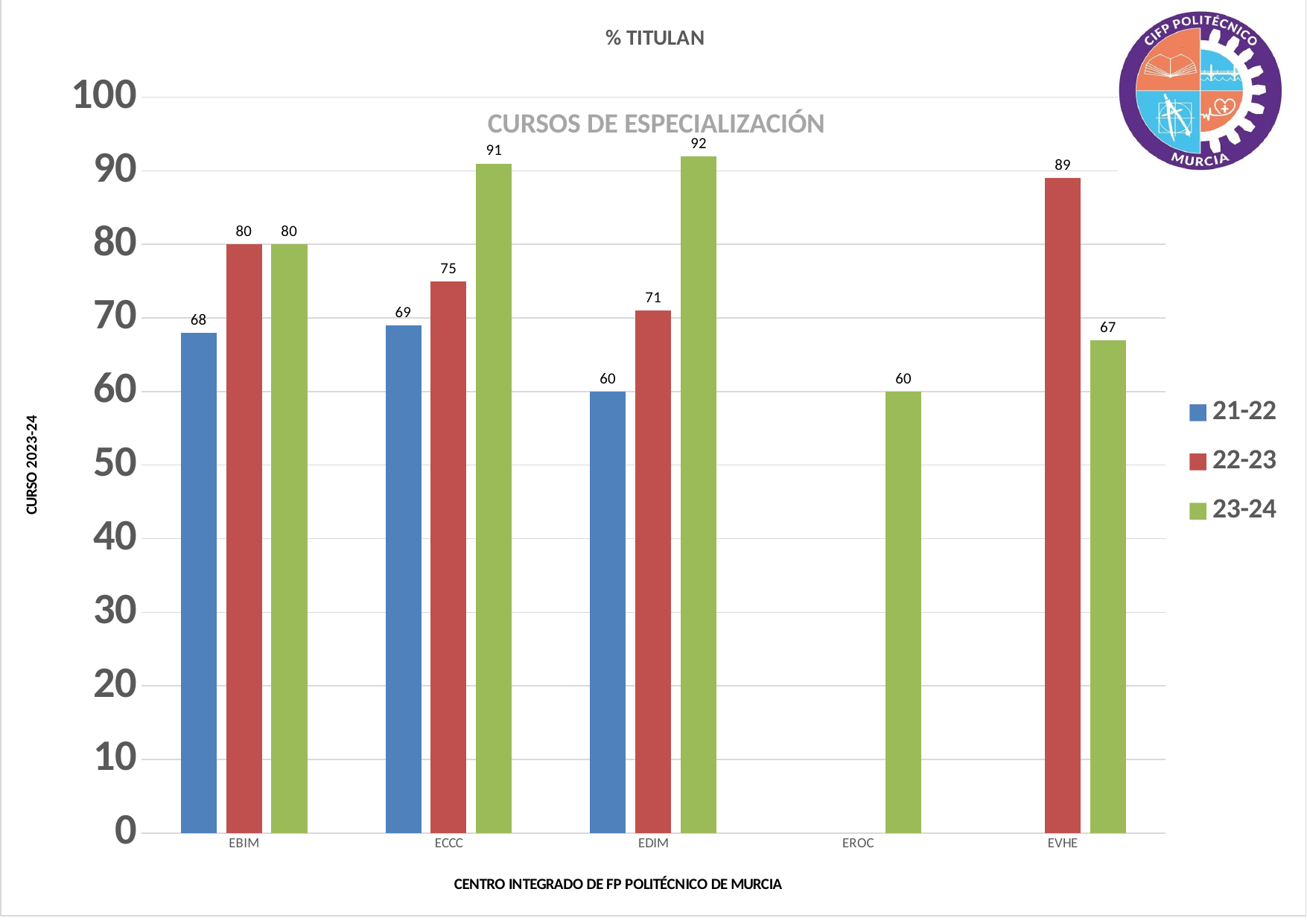
What is the difference between the 23-24 and 22-23 values for EDIM? 21 Is the value for EROC in the 23-24 series greater or less than 70? less What is the title of the chart? % TITULAN What is the value for EDIM in the 21-22 series? 60 Which category has the highest value in the 23-24 series? EDIM What kind of chart is shown on the slide? bar chart How many series does the legend list? 3 What is the value for EVHE in the 22-23 series? 89 Which category has the lowest value in the 21-22 series? EDIM How many categories are shown on the x axis? 5 Which is larger for EVHE: the 22-23 value or the 23-24 value? 22-23 What is the value for ECCC in the 23-24 series? 91